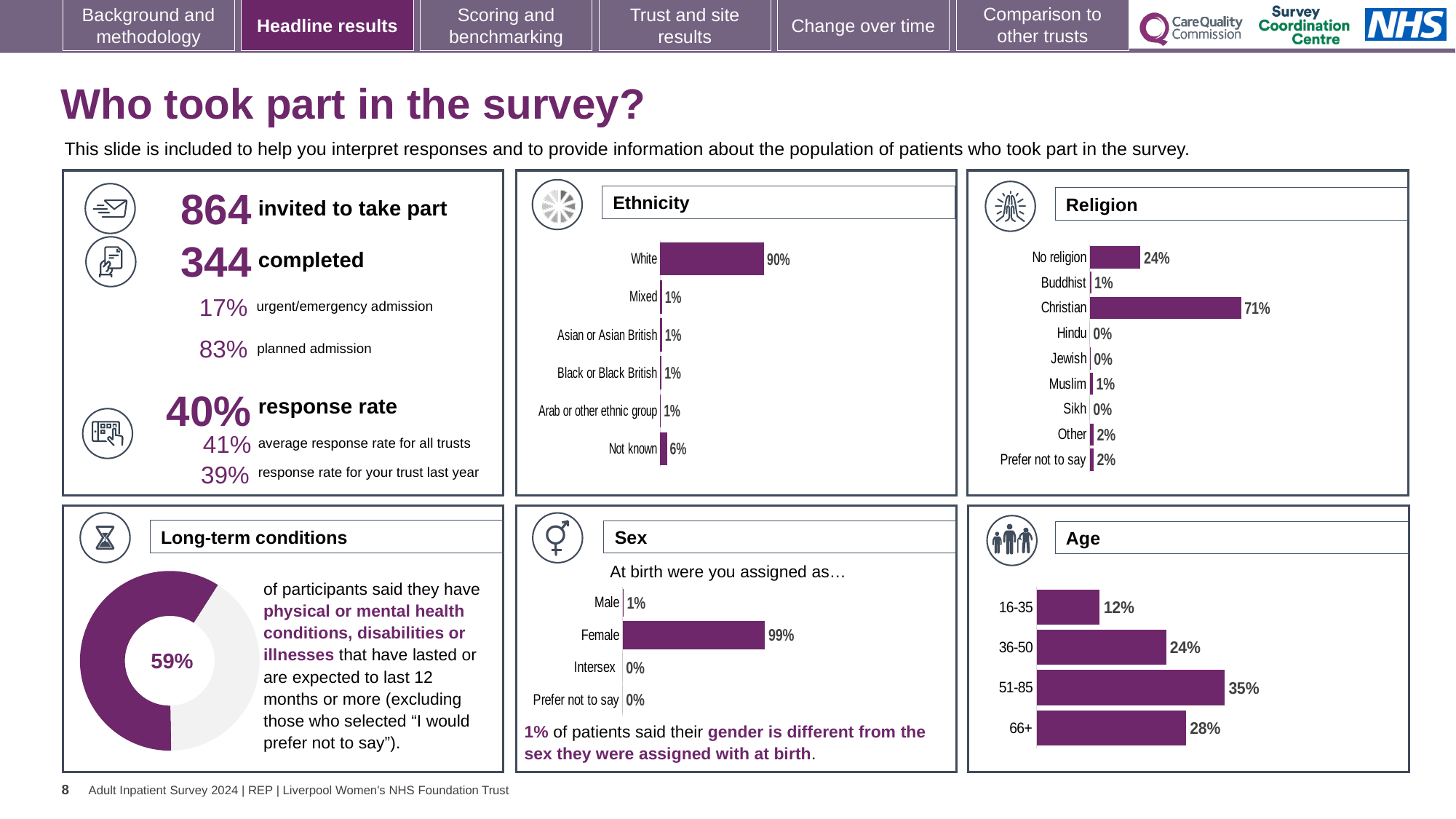
In the Religion chart, is the value for Christian larger or smaller than the value for No religion? larger In the Long-term conditions chart, what share of participants said they have long-term conditions? 59% In the Sex chart, how many categories are shown? 4 In the Age chart, which age group has the highest percentage? 51-85 In the Age chart, which age group has the lowest percentage? 16-35 In the Age chart, what is the difference between the 51-85 and 16-35 groups? 23% In the Ethnicity chart, what percentage of respondents are White? 90% In the Religion chart, what is the value for No religion? 24% In the Ethnicity chart, how many categories are shown? 6 In the Religion chart, which category has the highest value? Christian What kind of chart is used in the Long-term conditions panel? Doughnut chart In the Sex chart, what percentage of respondents were assigned Female at birth? 99%